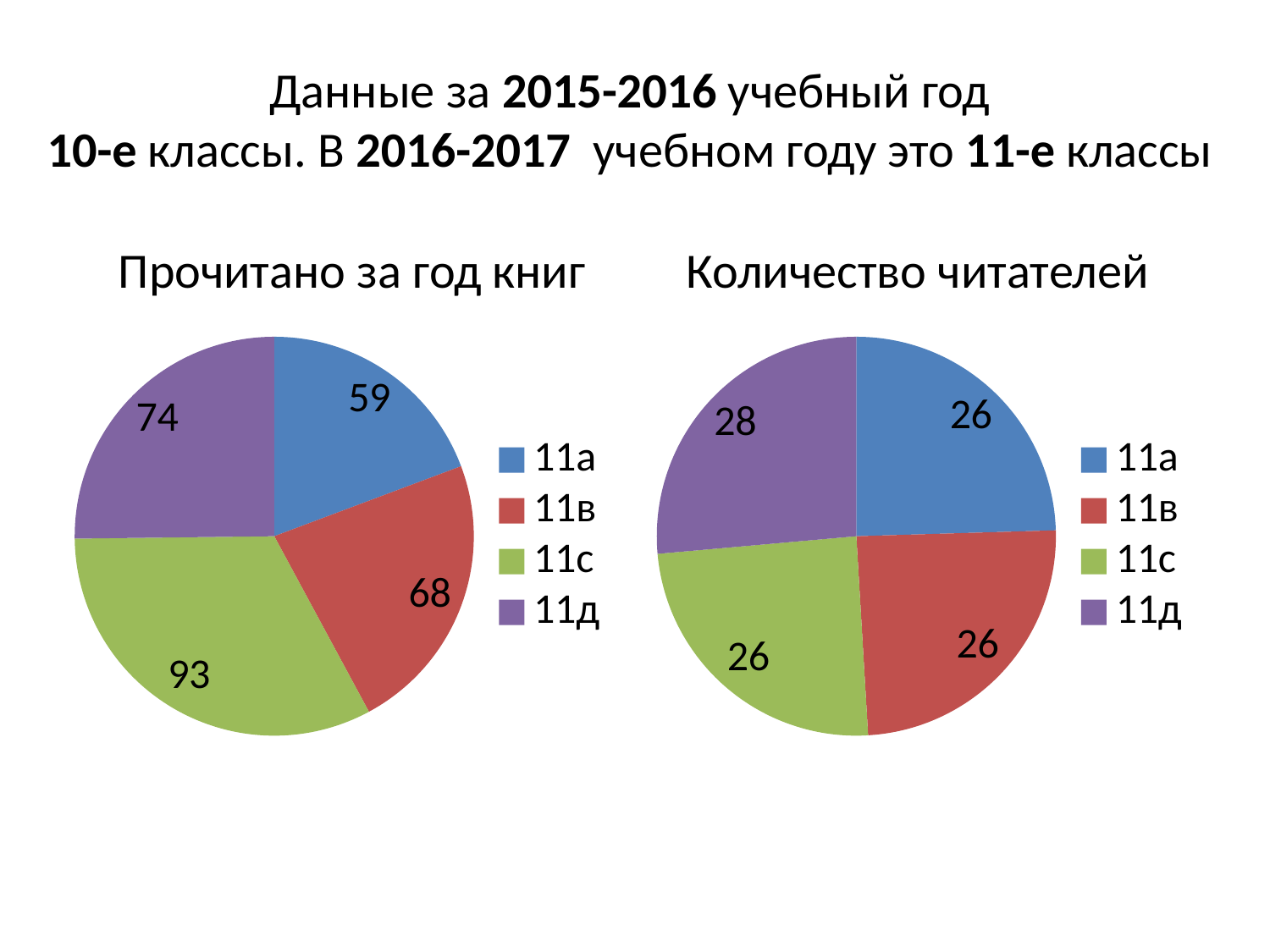
In the chart titled "Количество читателей", which class has the largest slice? 11д What type of chart is the chart titled "Прочитано за год книг"? pie chart In the chart titled "Прочитано за год книг", what is the difference between the values for 11с and 11а? 34 In the chart titled "Прочитано за год книг", which class has the largest slice? 11с In the chart titled "Прочитано за год книг", which is larger, the value for 11д or the value for 11в? 11д In the chart titled "Прочитано за год книг", what is the value for 11с? 93 In the chart titled "Количество читателей", which colour represents 11с in the legend? green In the chart titled "Количество читателей", how many slices does the pie have? 4 In the chart titled "Количество читателей", what is the total of all slices? 106 In the chart titled "Прочитано за год книг", which class has the smallest slice? 11а In the chart titled "Количество читателей", what is the value for 11д? 28 In the chart titled "Прочитано за год книг", what is the value for 11а? 59